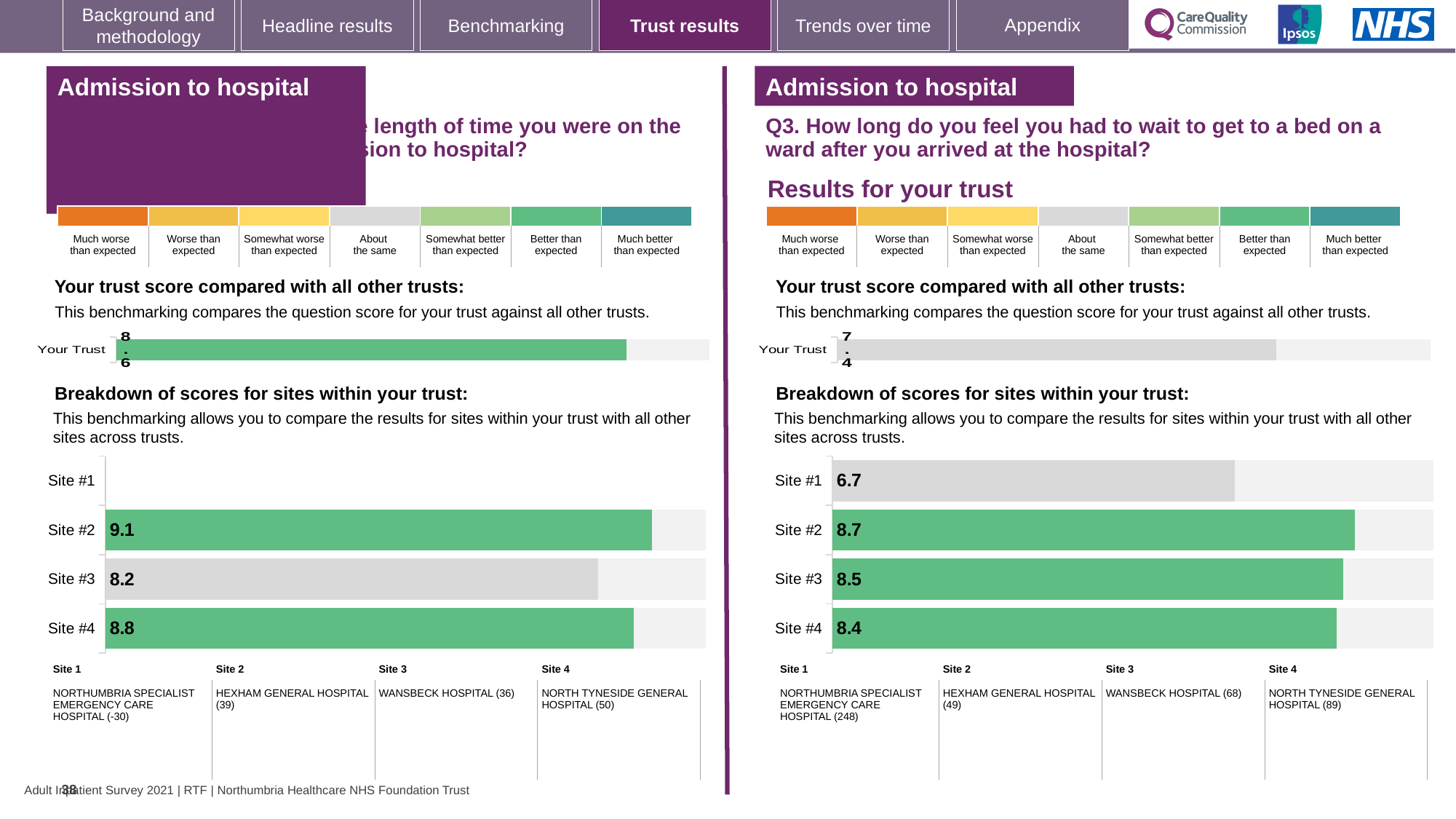
In the right-hand chart (Q3), which site has the lowest score in the breakdown of sites? Site #1 In the right-hand chart (Q3), what is the difference between the scores for Site #2 and Site #1? 2.0 In the right-hand chart (Q3, wait to get to a bed on a ward), what is the score for Site #2 in the breakdown of scores for sites? 8.7 In the left-hand chart (site breakdown), which site has the highest score? Site #2 In the right-hand chart (Q3), what is the 'Your Trust' score shown in the trust benchmarking bar? 7.4 In the left-hand chart, what is the 'Your Trust' score shown in the trust benchmarking bar? 8.6 In the right-hand chart (Q3), which site has the highest score in the breakdown of sites? Site #2 What kind of chart is used for the breakdown of scores for sites within the trust? Bar chart In the left-hand chart (site breakdown), what is the difference between the scores for Site #2 and Site #3? 0.9 In the right-hand chart (Q3), which has the larger score, Site #2 or Site #4? Site #2 In the left-hand chart (site breakdown), what is the score for Site #2? 9.1 In the left-hand chart (site breakdown), among the sites with a plotted score, which site has the lowest score? Site #3